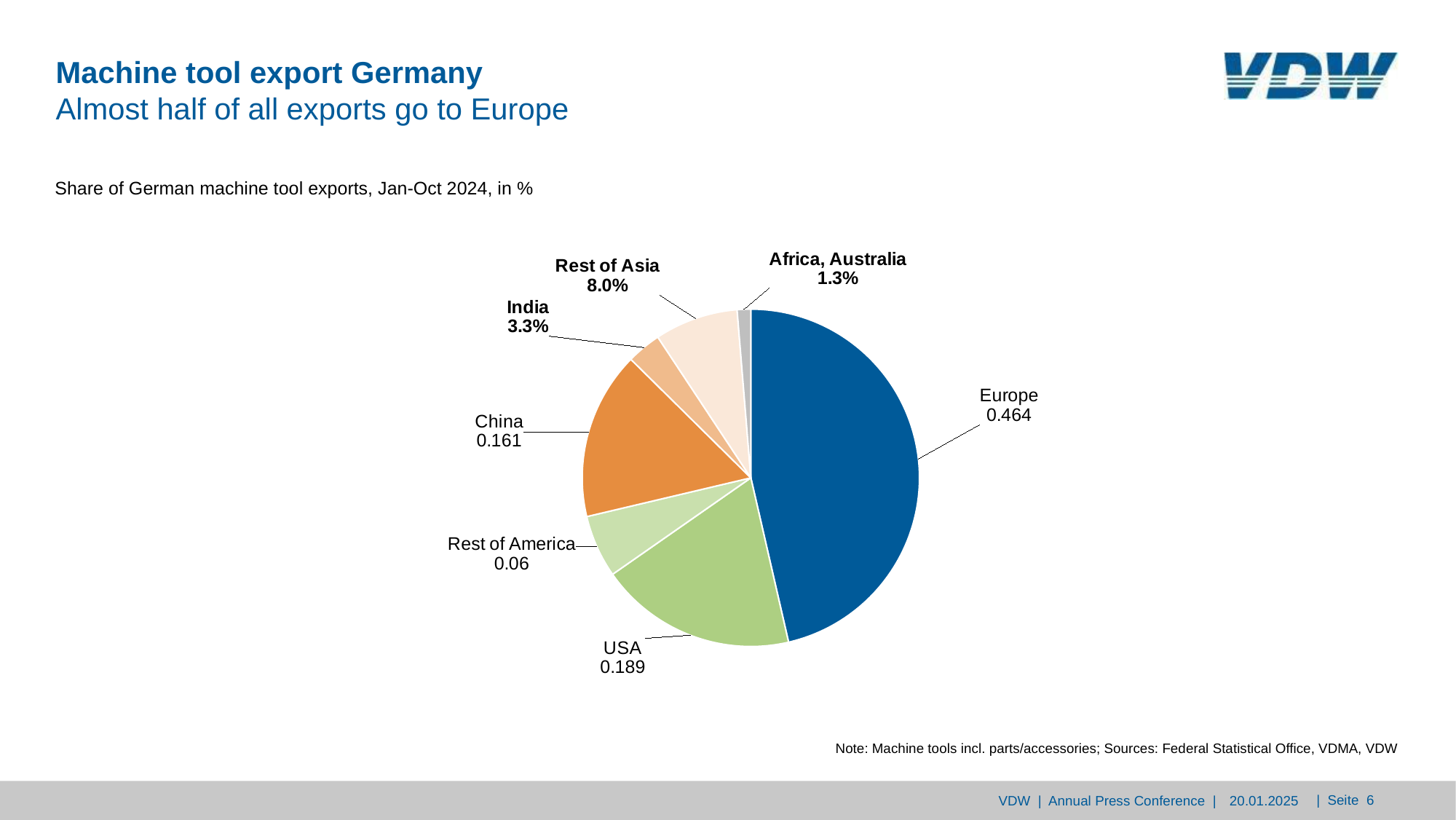
What value is shown for Rest of America in the pie chart? 0.06 What value is shown for China in the pie chart? 0.161 Which region has the largest slice of the pie chart? Europe Which region has the smallest slice of the pie chart? Africa, Australia How many slices does the pie chart have? 7 What share is shown for India in the pie chart? 3.3% What share is shown for Rest of Asia in the pie chart? 8.0% What value is shown for Europe in the pie chart? 0.464 What kind of chart is shown on the slide? pie chart Which is larger in the pie chart, the value for USA or the value for China? USA What value is shown for USA in the pie chart? 0.189 What share is shown for Africa, Australia in the pie chart? 1.3%